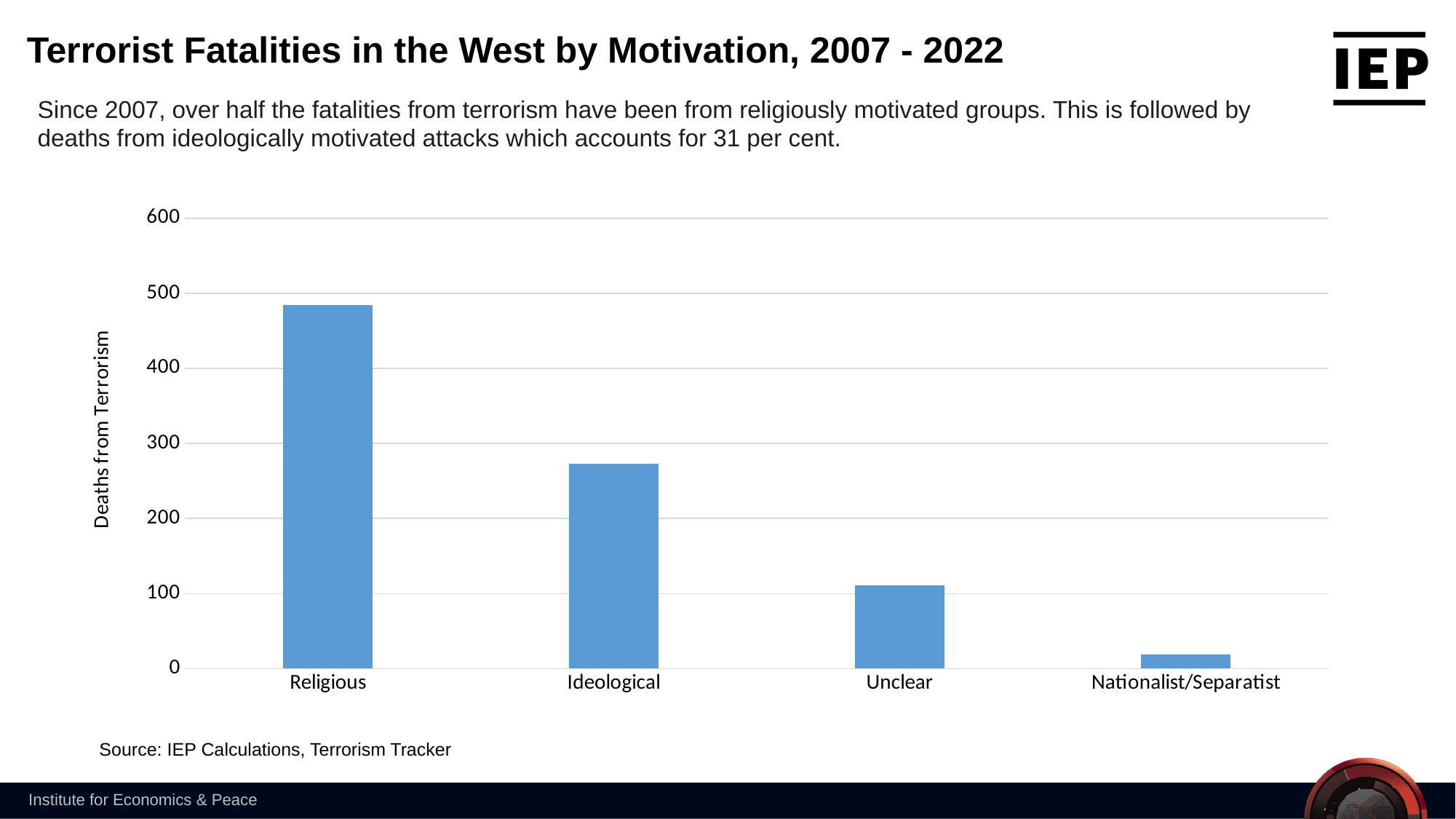
Is the value for Religious greater or less than 400? greater How many motivation categories are plotted on the chart? 4 Do the bar values rise or fall moving from left to right along the x axis? fall Is the value for Nationalist/Separatist greater or less than 100? less Is the value for Unclear greater or less than 100? greater What is the title of the chart? Terrorist Fatalities in the West by Motivation, 2007 - 2022 What kind of chart is shown on the slide? bar chart Which has more deaths from terrorism, Ideological or Unclear? Ideological Which motivation category has the highest number of deaths from terrorism? Religious Which motivation category has the lowest number of deaths from terrorism? Nationalist/Separatist What is the label of the vertical axis? Deaths from Terrorism